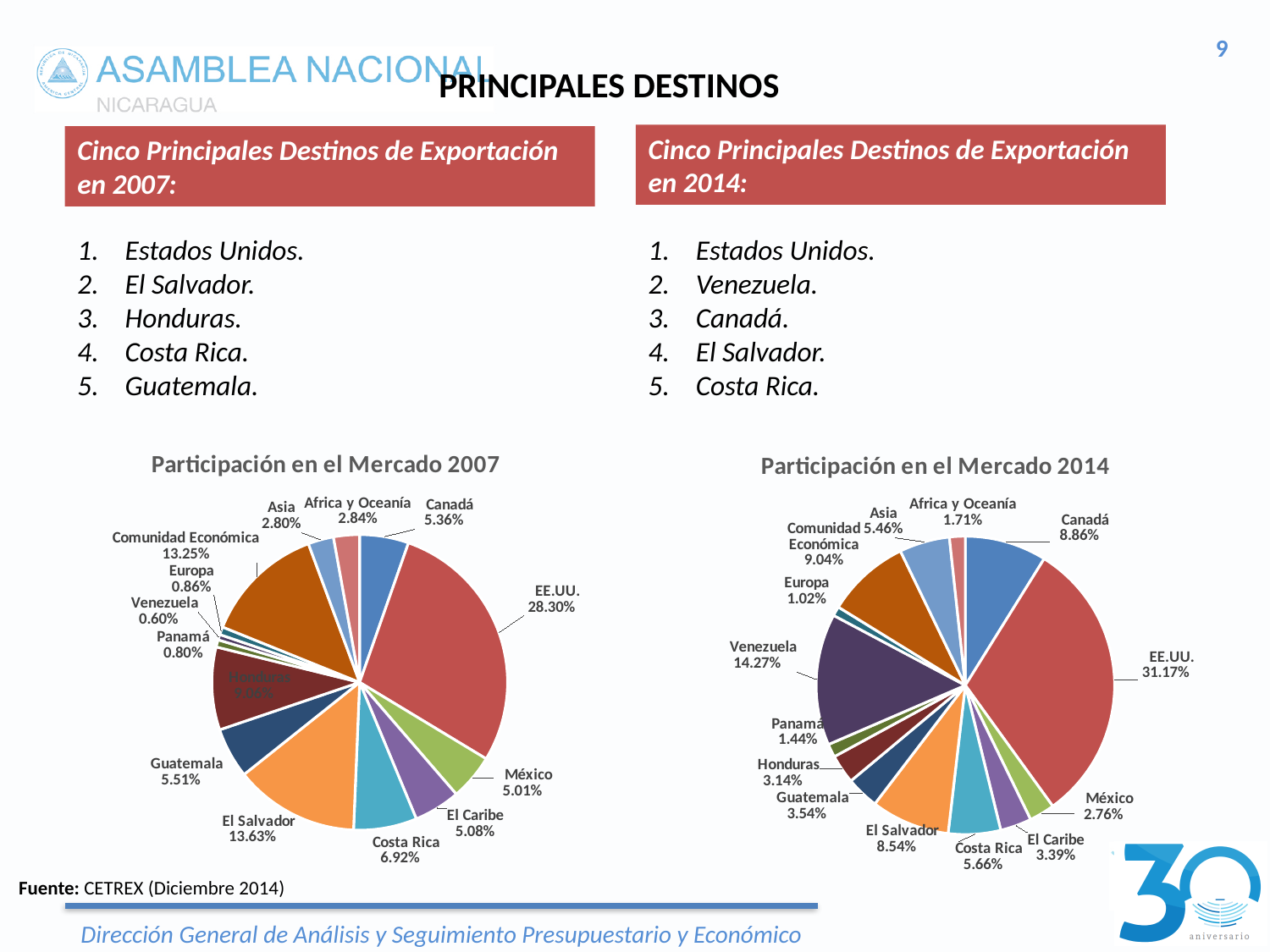
In the "Participación en el Mercado 2007" chart, which category has the largest share? EE.UU. How many categories are shown in the "Participación en el Mercado 2014" pie chart? 14 In the "Participación en el Mercado 2014" chart, which is larger: the share of Canadá or the share of El Salvador? Canadá In the "Participación en el Mercado 2007" chart, what is the share for El Salvador? 13.63% What type of chart is "Participación en el Mercado 2007"? Pie chart In the "Participación en el Mercado 2014" chart, what is the share for EE.UU.? 31.17% In the "Participación en el Mercado 2007" chart, which is larger: the share of Comunidad Económica or the share of Costa Rica? Comunidad Económica What is the title of the pie chart on the left side of the slide? Participación en el Mercado 2007 In the "Participación en el Mercado 2007" chart, which category has the smallest share? Venezuela In the "Participación en el Mercado 2014" chart, which category has the smallest share? Europa In the "Participación en el Mercado 2014" chart, what is the difference between the shares of EE.UU. and Venezuela? 16.90% In the "Participación en el Mercado 2014" chart, what is the share for Venezuela? 14.27%